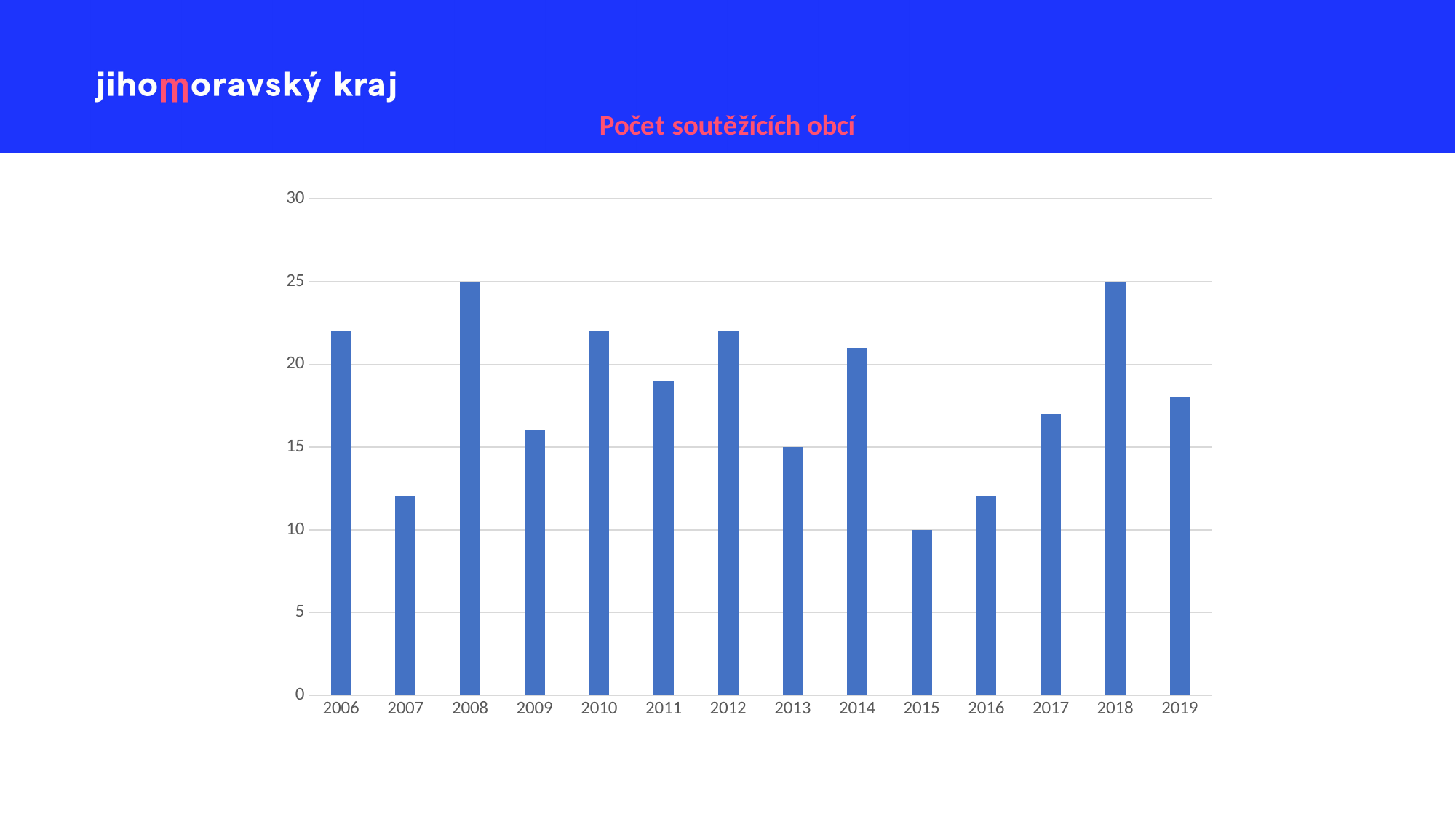
How many years are shown on the x axis of the chart? 14 What is the value for 2015? 10 Is the value for 2011 greater or less than 20? less Which year has the lowest value? 2015 What is the difference between the values for 2008 and 2015? 15 What is the title of the chart? Počet soutěžících obcí What type of chart is shown on the slide? bar chart What is the value for 2013? 15 What is the value for 2008? 25 Is the value for 2009 greater or less than 15? greater Which year has the larger value, 2006 or 2007? 2006 Is the value for 2006 greater or less than 20? greater